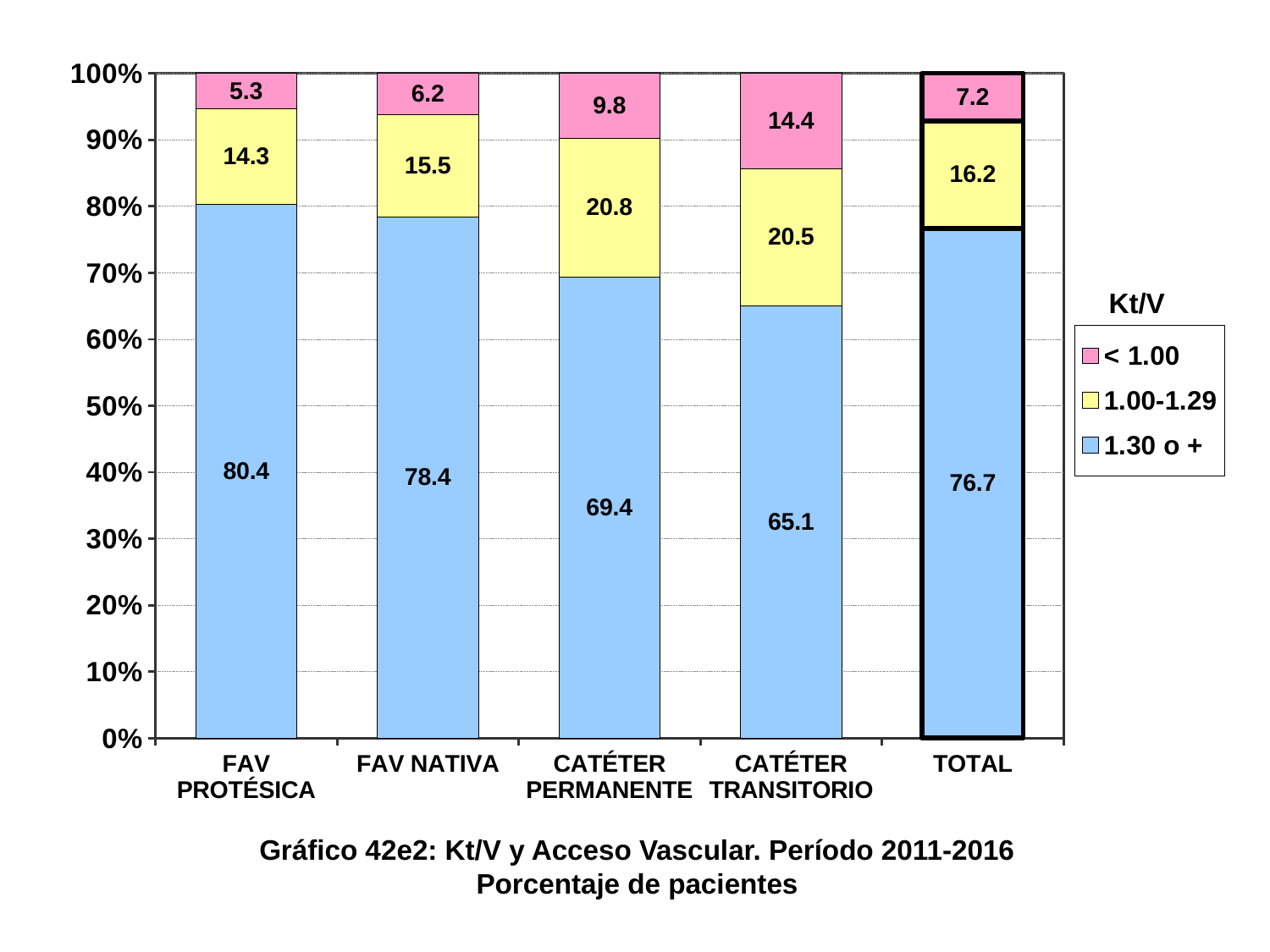
Which is larger: the '1.00-1.29' value for CATÉTER PERMANENTE or for CATÉTER TRANSITORIO? CATÉTER PERMANENTE What is the title of the chart? Gráfico 42e2: Kt/V y Acceso Vascular. Período 2011-2016 Porcentaje de pacientes What is the difference between the '1.30 o +' values for FAV NATIVA and CATÉTER TRANSITORIO? 13.3 What kind of chart is shown on the slide? Stacked bar chart How many series does the legend list? 3 Which category has the lowest value for the '< 1.00' series? FAV PROTÉSICA What is the value of the '1.30 o +' series for FAV PROTÉSICA? 80.4 What is the value of the '1.00-1.29' series for TOTAL? 16.2 Which category has the highest value for the '1.30 o +' series? FAV PROTÉSICA What is the title of the legend? Kt/V What is the value of the '< 1.00' series for CATÉTER TRANSITORIO? 14.4 How many categories are shown on the x axis? 5